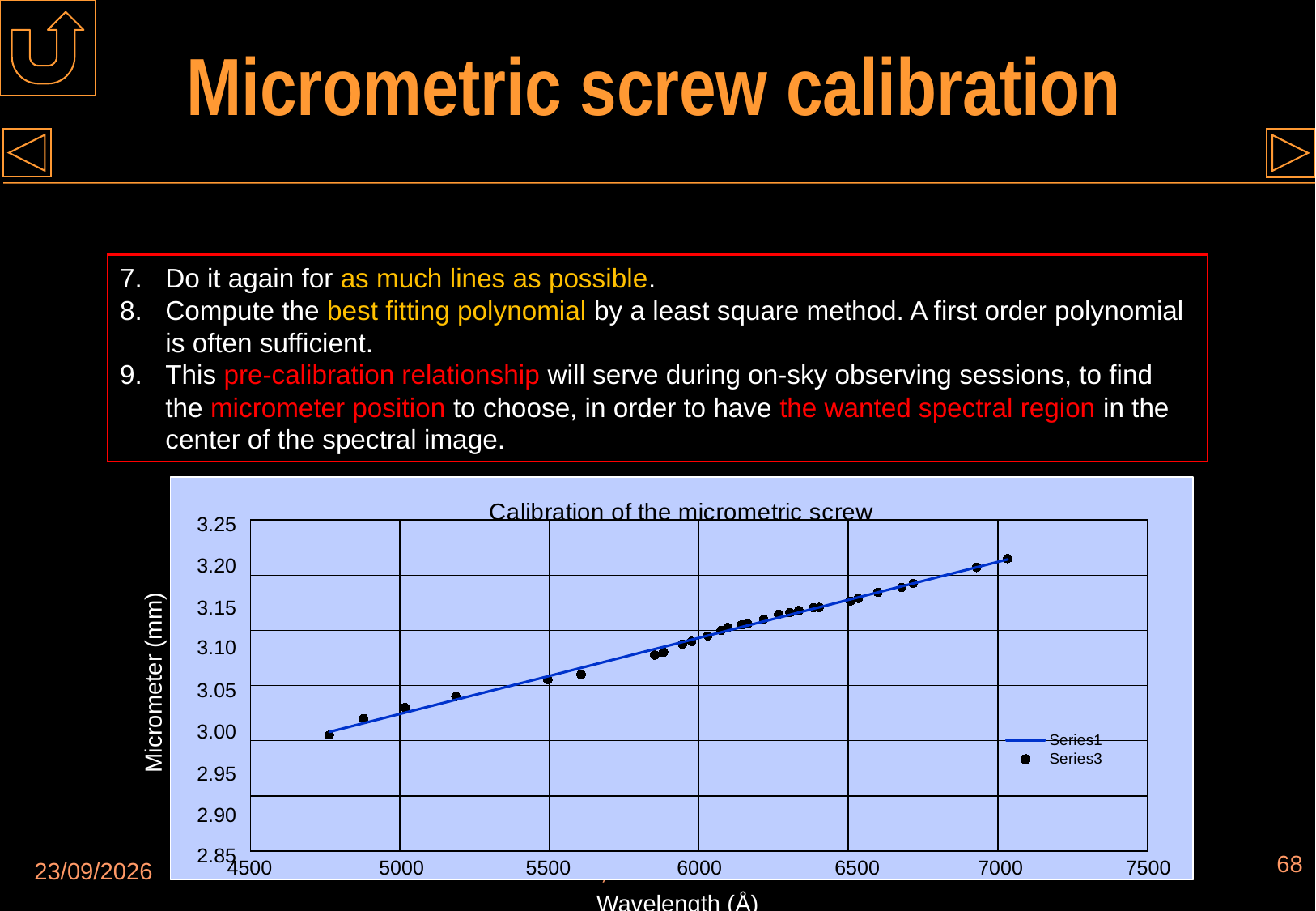
How many series does the chart legend list? 2 What is the label of the y axis? Micrometer (mm) Which has the larger micrometer value: the point near 5000 Å or the point near 7000 Å? The point near 7000 Å Is the micrometer value at a wavelength of about 5000 Å greater or less than 3.05? less What is the title of the chart? Calibration of the micrometric screw Is the micrometer value at a wavelength of about 6500 Å greater or less than 3.10? greater What kind of chart is shown on the slide? Scatter plot with a fitted line Is the micrometer value at a wavelength of about 5500 Å greater or less than 3.10? less Do the micrometer values rise or fall as wavelength increases along the x axis? Rise Which series is drawn as a line rather than as points? Series1